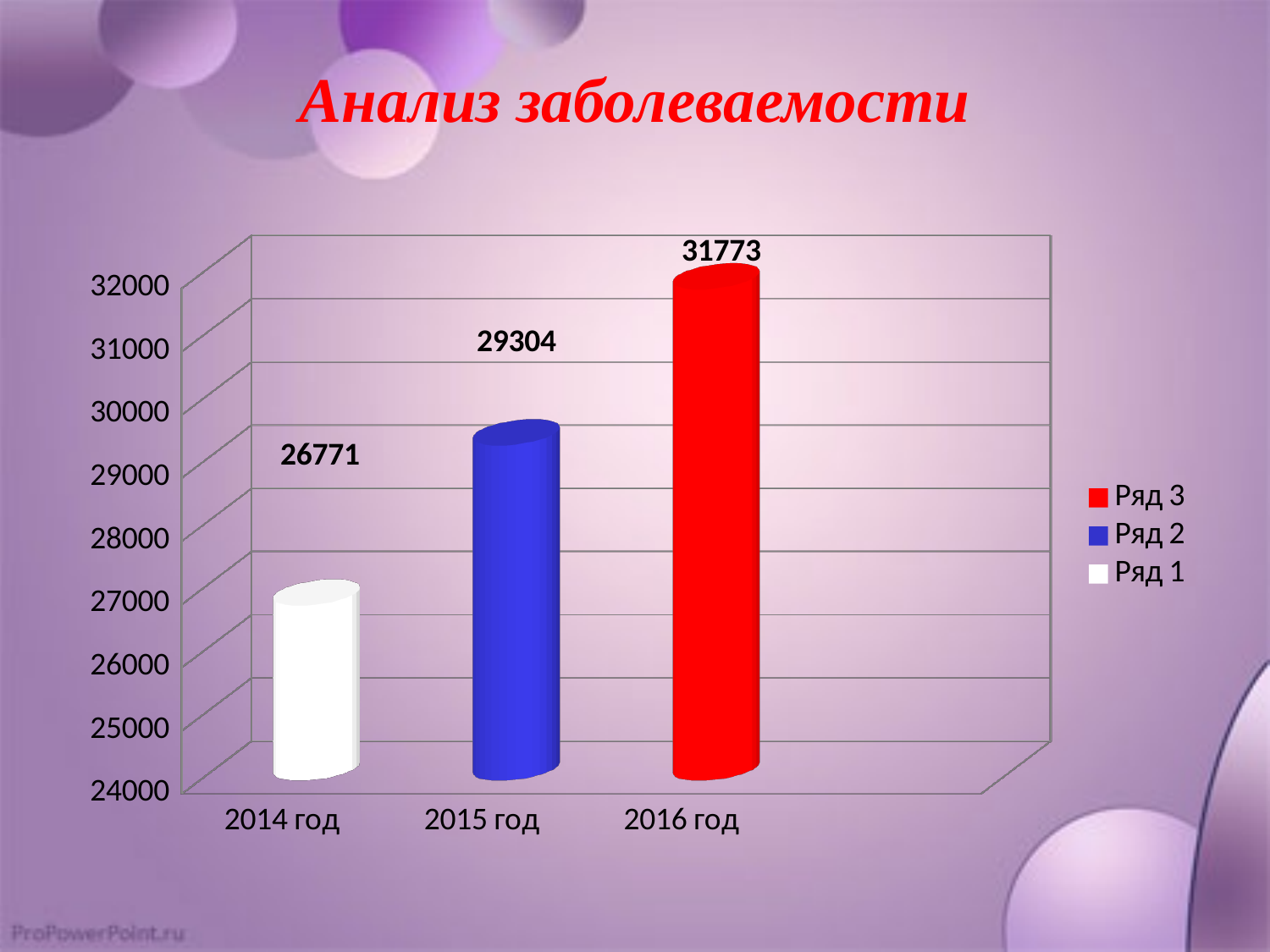
Is the value for 2015 год greater or less than 30000? less What is the difference between the values for 2016 год and 2014 год? 5002 Which is larger, the value for 2015 год or the value for 2016 год? 2016 год What is the value for 2015 год? 29304 How many series does the legend list? 3 Which year has the lowest value? 2014 год What kind of chart is shown on the slide? bar chart What is the value for 2016 год? 31773 How many years are shown on the x axis? 3 Which year has the highest value? 2016 год What is the value for 2014 год? 26771 What is the difference between the values for 2015 год and 2014 год? 2533